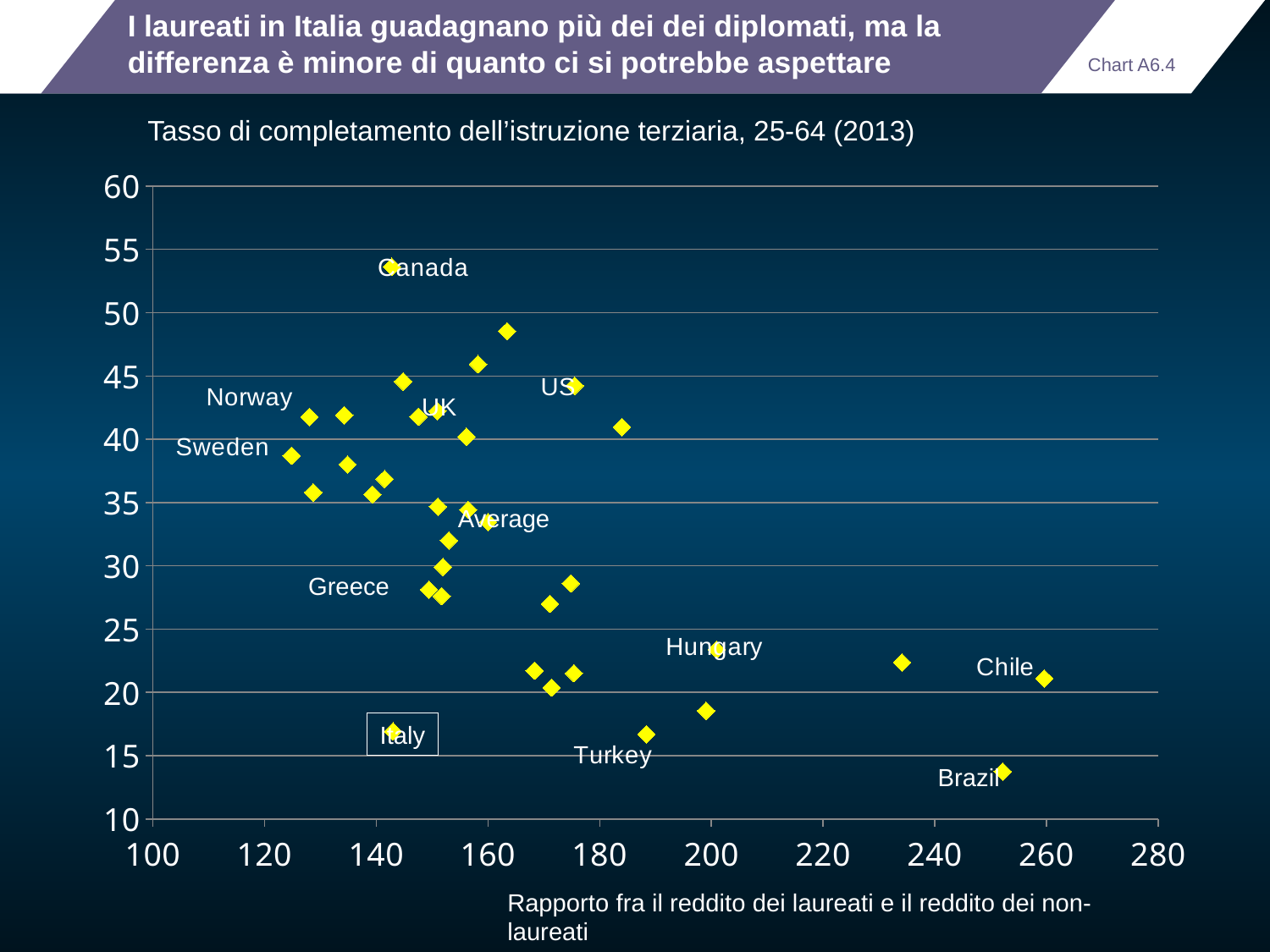
Which labelled country has the lowest tertiary attainment rate (vertical axis)? Brazil What is the title of the chart? Tasso di completamento dell'istruzione terziaria, 25-64 (2013) Which labelled country has the highest tertiary attainment rate (vertical axis)? Canada Is the tertiary attainment rate for Italy greater or less than 20? less What kind of chart is shown on the slide? scatter chart Which has a higher tertiary attainment rate, Norway or Turkey? Norway Is the earnings ratio for Sweden greater or less than 140? less Is the tertiary attainment rate for Canada greater or less than 50? greater Which labelled country has the highest earnings ratio (horizontal axis)? Chile As the earnings ratio on the horizontal axis increases, does the tertiary attainment rate generally rise or fall? fall